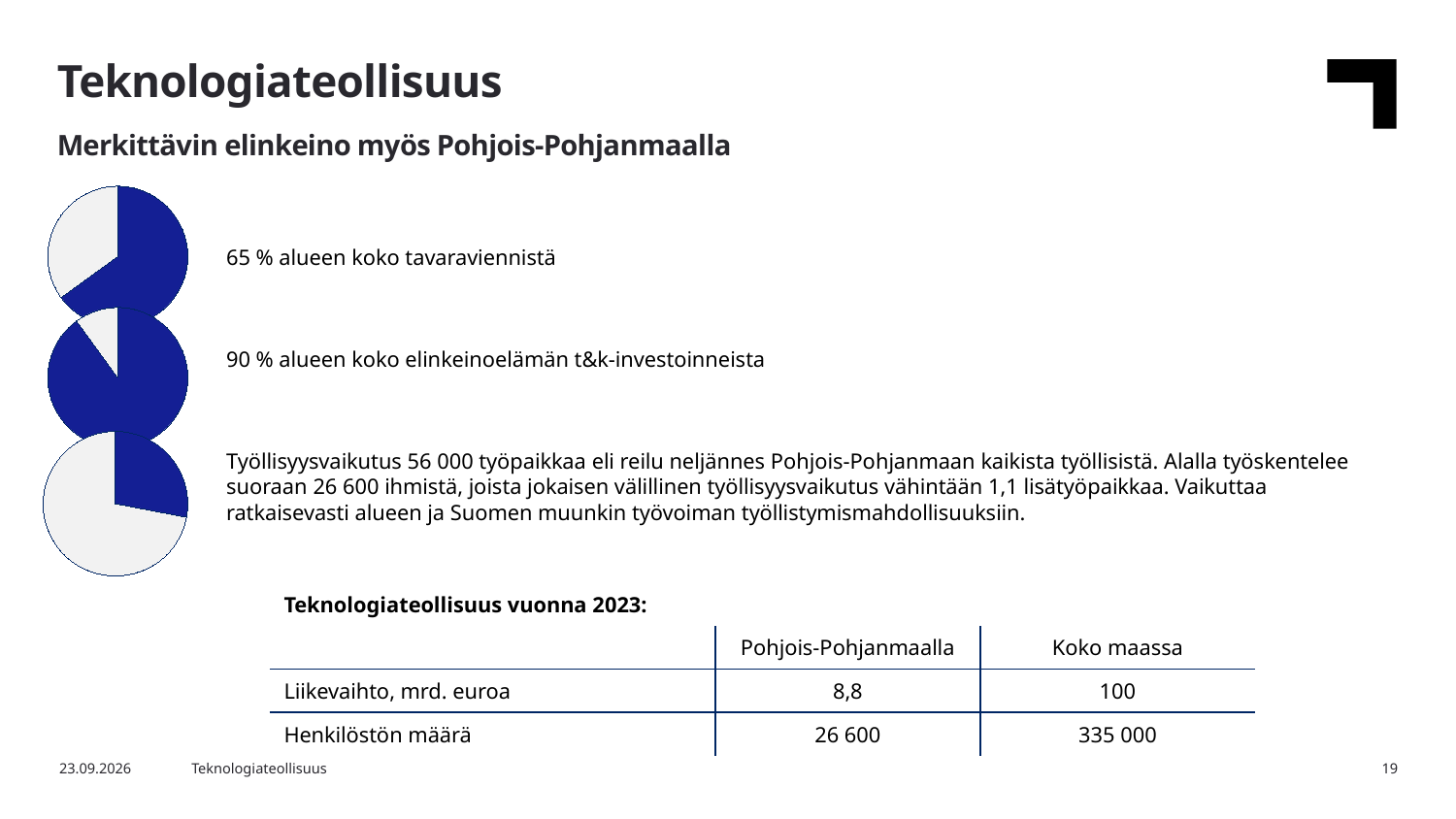
In the middle pie chart, what share does the blue slice represent (share of the region's business R&D investments)? 90 % What does the top pie chart represent, according to the text next to it? 65 % alueen koko tavaraviennistä Of the three pie charts, which one has the largest highlighted (blue) share? The middle one What kind of chart is shown at the top left of the slide? Pie chart Of the three pie charts, which one has the smallest highlighted (blue) share? The bottom one Which pie chart has the larger blue slice, the top one or the middle one? The middle one How many slices does the top pie chart have? 2 Is the blue slice in the bottom pie chart greater or less than 50 %? less What colour is the highlighted slice in the pie charts? Blue How many pie charts are on the slide? 3 In the top pie chart, what share does the blue slice represent (share of the region's total goods exports)? 65 % Which pie chart has the larger blue slice, the top one or the bottom one? The top one